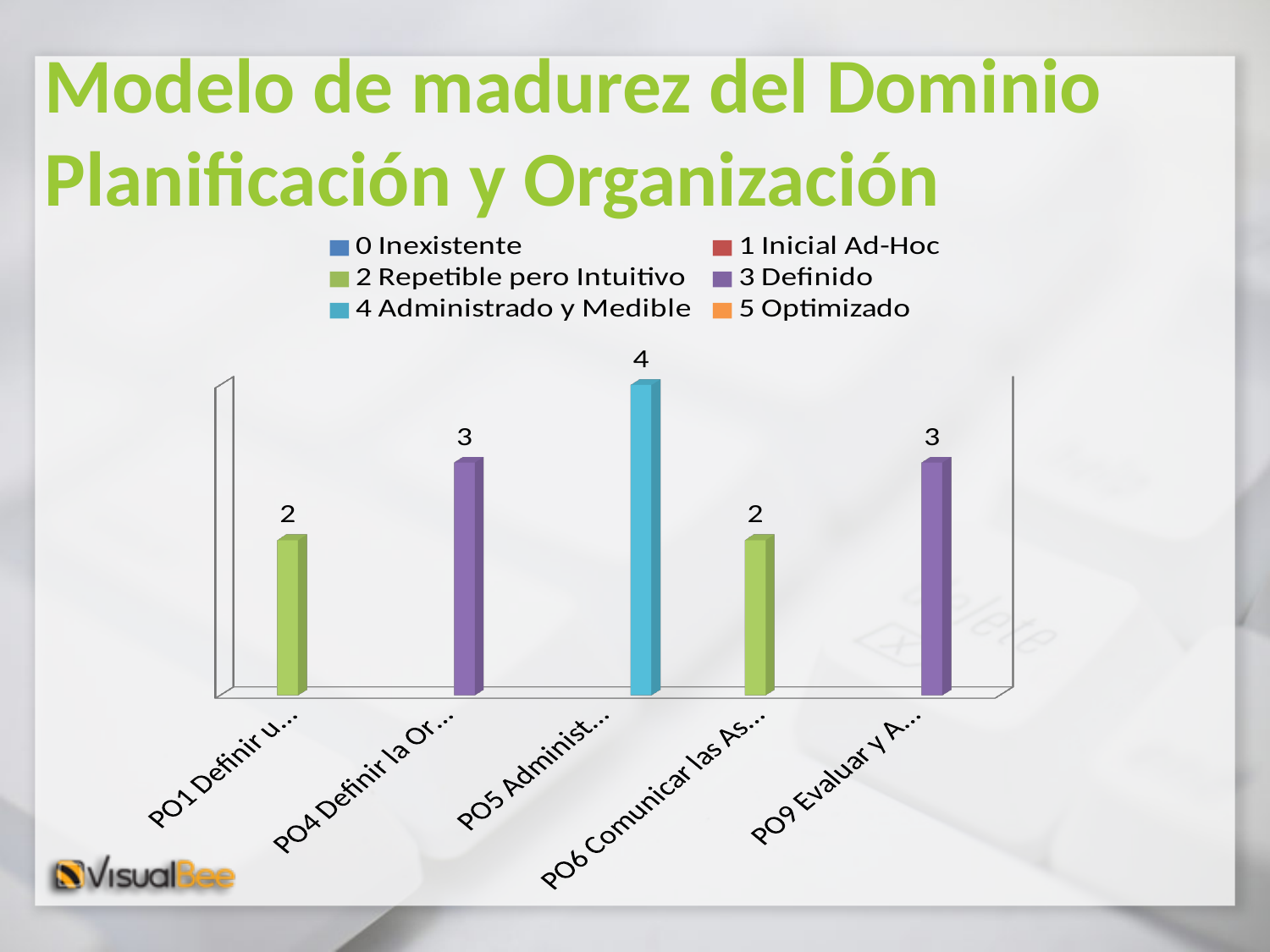
What is the difference between the values for PO4 and PO1? 1 What is the value shown for the PO1 bar? 2 What is the title of the slide containing the chart? Modelo de madurez del Dominio Planificación y Organización How many entries does the legend list? 6 According to the legend, which maturity level does the colour of the PO5 bar represent? 4 Administrado y Medible Which category has the highest bar? PO5 Which is larger, the value for PO4 or the value for PO6? PO4 What is the value shown for the PO9 bar? 3 What is the difference between the values for PO5 and PO6? 2 What kind of chart is shown on the slide? Bar chart What is the value shown for the PO5 bar? 4 How many bars (categories) are plotted in the chart? 5